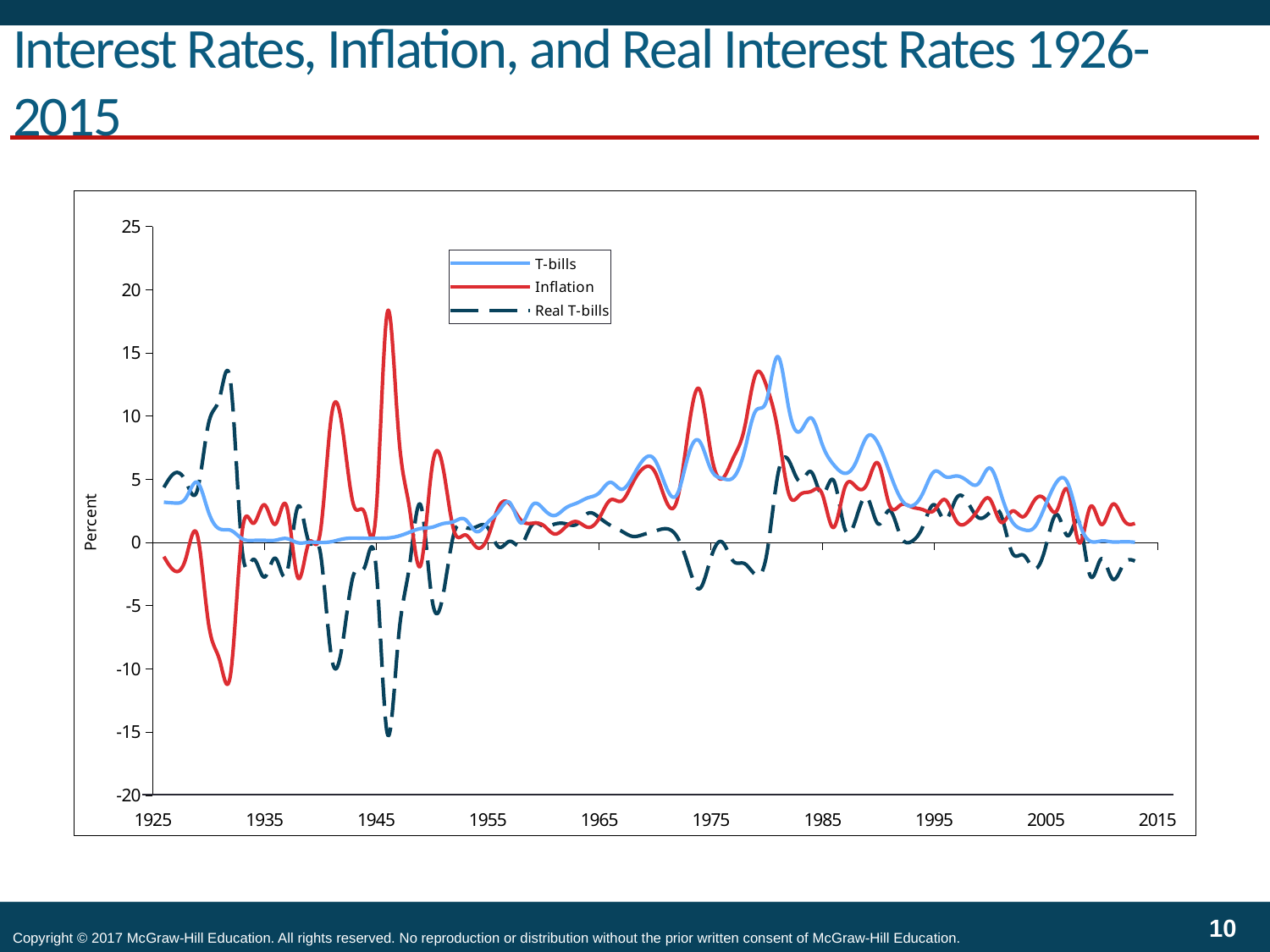
Is the peak value of the T-bills line greater or less than 10? greater Is the lowest value of the Real T-bills line greater or less than -10? less Does the T-bills line generally rise or fall from its peak around 1981 to 2015? fall Is the lowest value of the T-bills line greater or less than -5? greater How many series does the legend list? 3 What kind of chart is shown on the slide? line chart Around 1946, which series has the larger value: Inflation or T-bills? Inflation Which series reaches the lowest value anywhere on the chart? Real T-bills Which series is drawn as a dashed line in the chart? Real T-bills Which series reaches the highest value anywhere on the chart? Inflation What is the label on the vertical axis of the chart? Percent